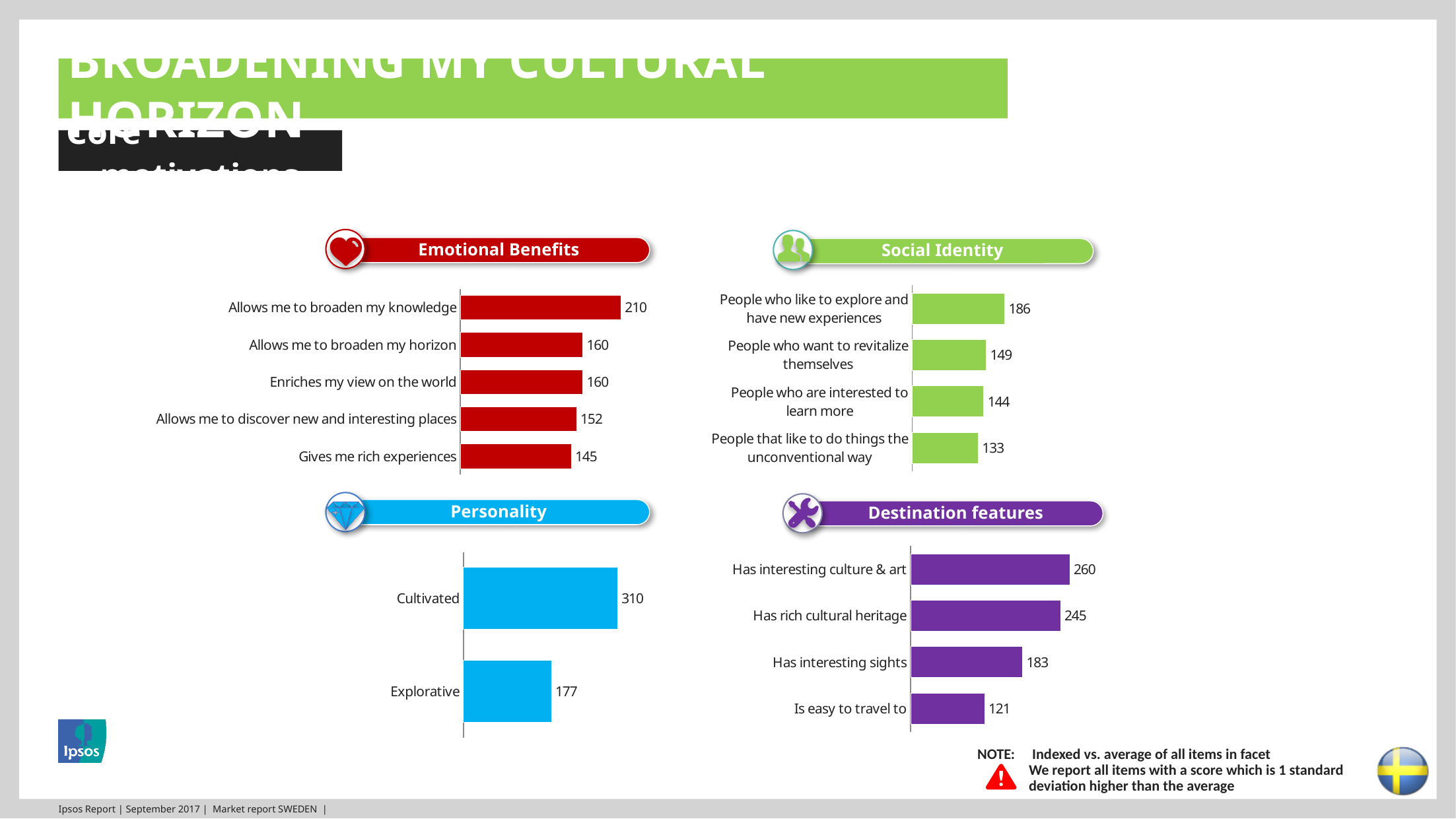
In the Emotional Benefits chart, which category has the lowest value? Gives me rich experiences In the Emotional Benefits chart, how many categories are shown? 5 In the Social Identity chart, which category has the highest value? People who like to explore and have new experiences In the Destination features chart, what is the value for "Is easy to travel to"? 121 What type of chart is used in the Personality section? Bar chart In the Personality chart, what is the value for Explorative? 177 In the Social Identity chart, what is the difference between the highest and lowest values? 53 In the Emotional Benefits chart, what is the value for "Allows me to broaden my knowledge"? 210 In the Personality chart, what is the difference between Cultivated and Explorative? 133 In the Destination features chart, which category has the highest value? Has interesting culture & art In the Destination features chart, which is larger: "Has rich cultural heritage" or "Has interesting sights"? Has rich cultural heritage In the Social Identity chart, what is the value for "People who want to revitalize themselves"? 149